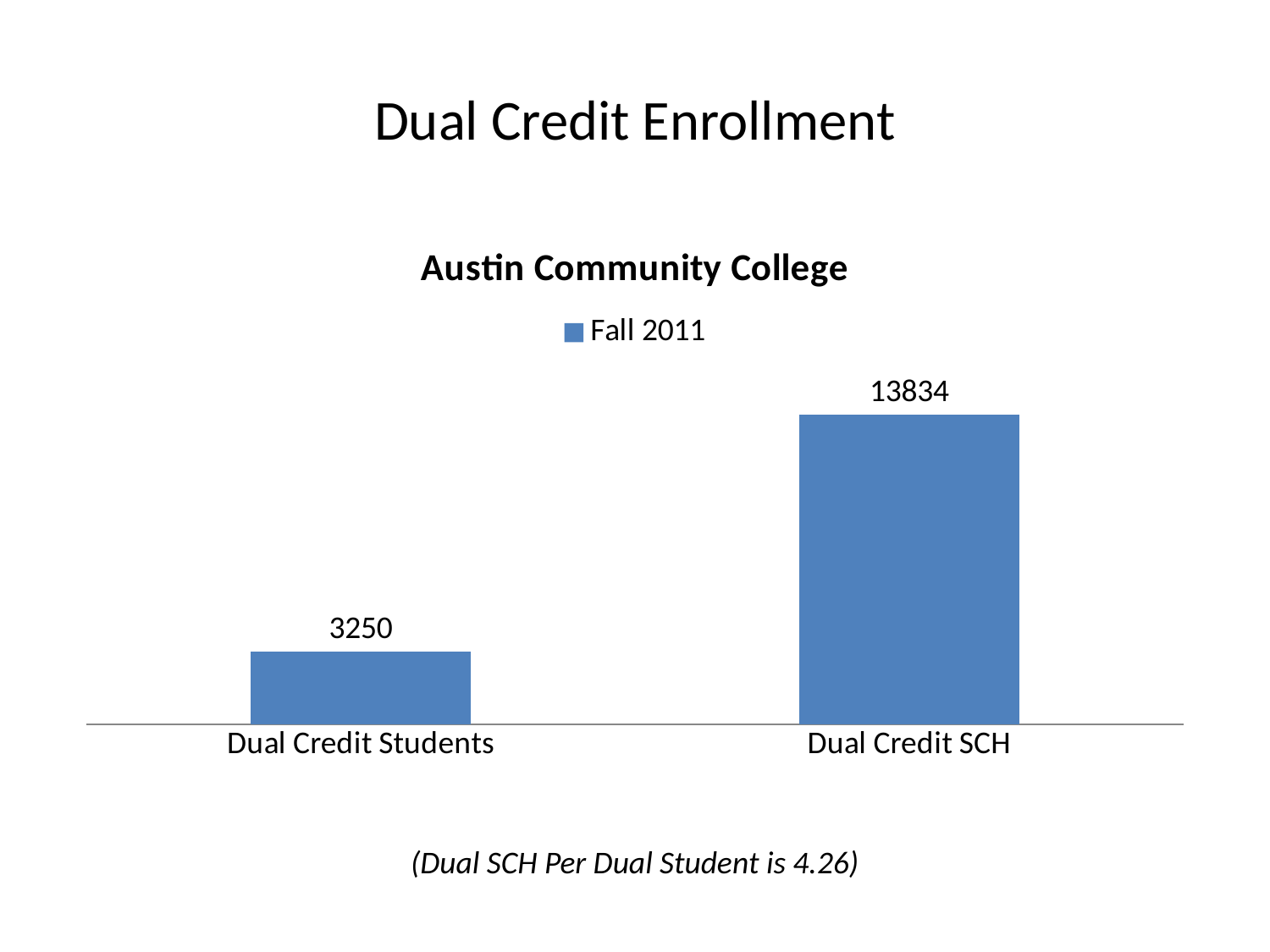
What is the value for Dual Credit SCH? 13834 What is the value for Dual Credit Students? 3250 Which category has the lowest value? Dual Credit Students What is the difference between the Dual Credit SCH value and the Dual Credit Students value? 10584 How many series does the legend list? 1 What kind of chart is shown on the slide? Bar chart What is the title of the chart? Austin Community College Which is larger, Dual Credit Students or Dual Credit SCH? Dual Credit SCH Which category has the highest value? Dual Credit SCH How many categories are shown on the chart? 2 What series name is listed in the legend? Fall 2011